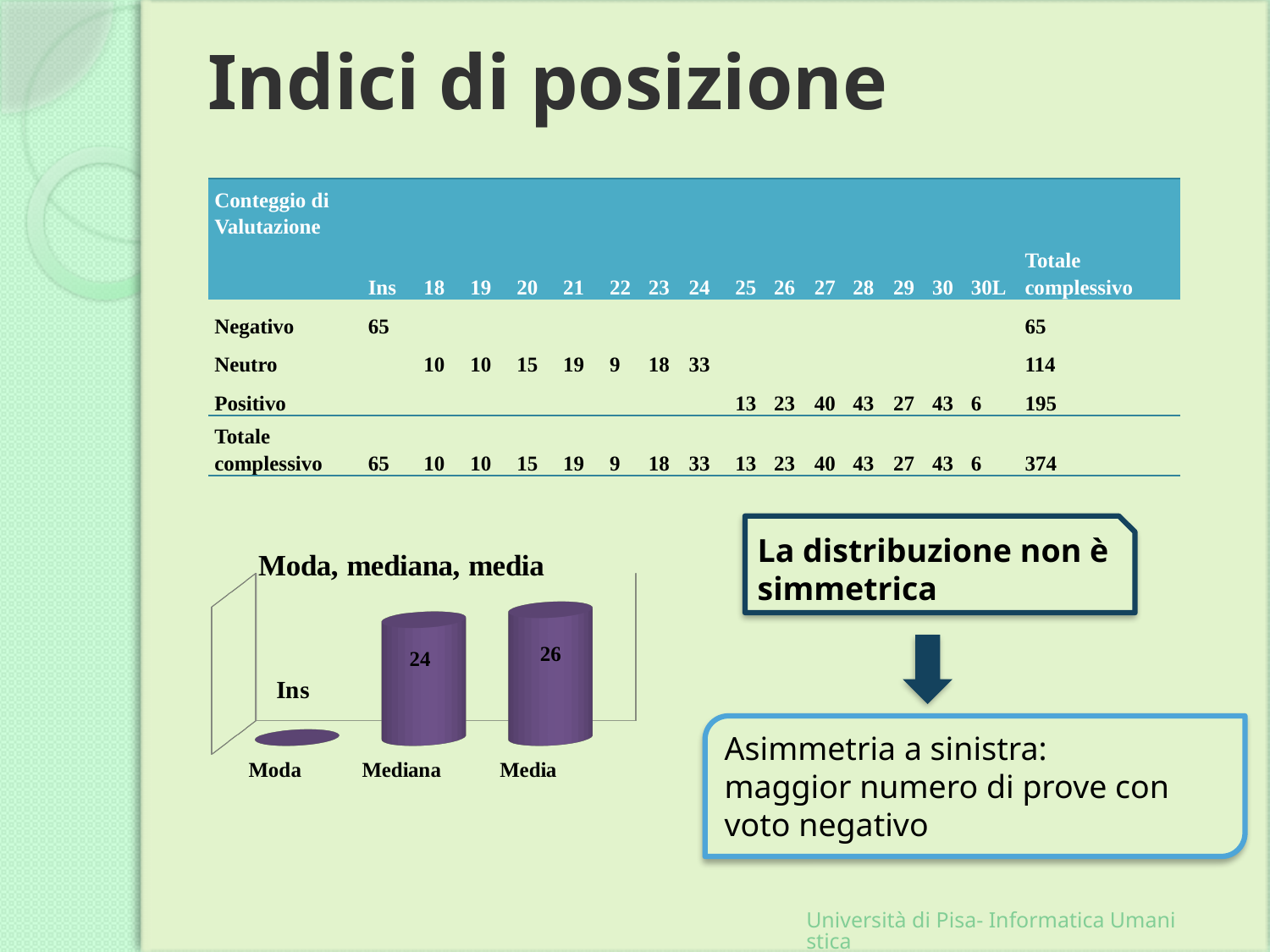
What kind of chart is shown on the slide? Bar chart What is the title of the chart? Moda, mediana, media What colour are the bars in the chart? Purple What is the value shown for Mediana in the chart? 24 What is the value shown for Media in the chart? 26 How many categories are shown on the x axis of the chart? 3 What label is shown on the Moda bar in the chart? Ins What is the difference between the values for Media and Mediana? 2 Which is larger, the value for Mediana or the value for Media? Media Which category has the lowest bar in the chart? Moda Which category has the tallest bar in the chart? Media